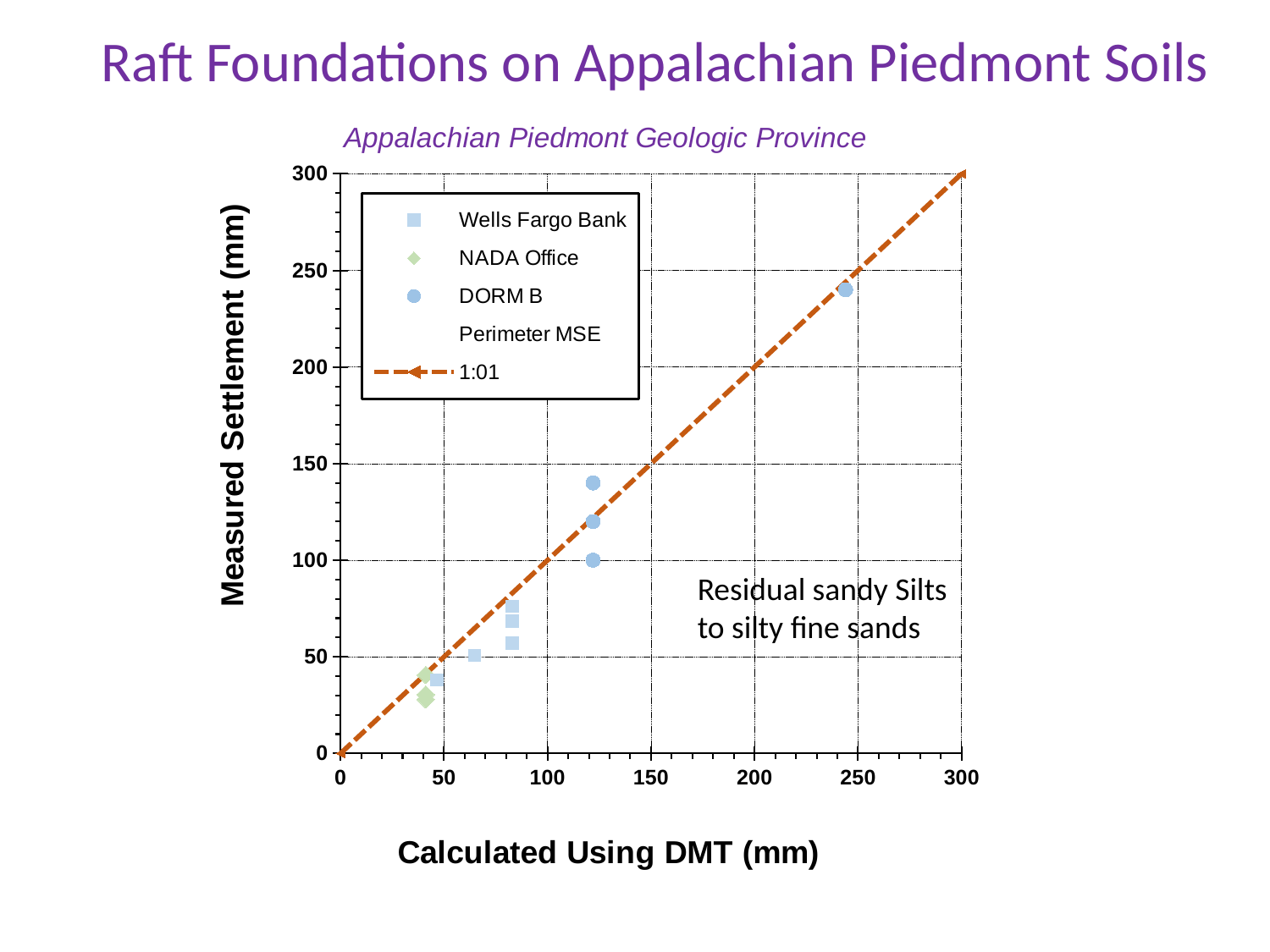
Are the measured settlements of the NADA Office points greater or less than 50? less Is the measured settlement of the lowest DORM B point greater or less than 150? less What is the label of the x axis? Calculated Using DMT (mm) What is the highest value shown on the y axis? 300 Are the calculated DMT values of the Wells Fargo Bank points greater or less than 100? less Which series contains the point with the highest measured settlement? DORM B What kind of chart is shown on the slide? scatter chart What is the title of the chart? Appalachian Piedmont Geologic Province Which series contains the point with the lowest measured settlement? NADA Office How many entries does the chart legend list? 5